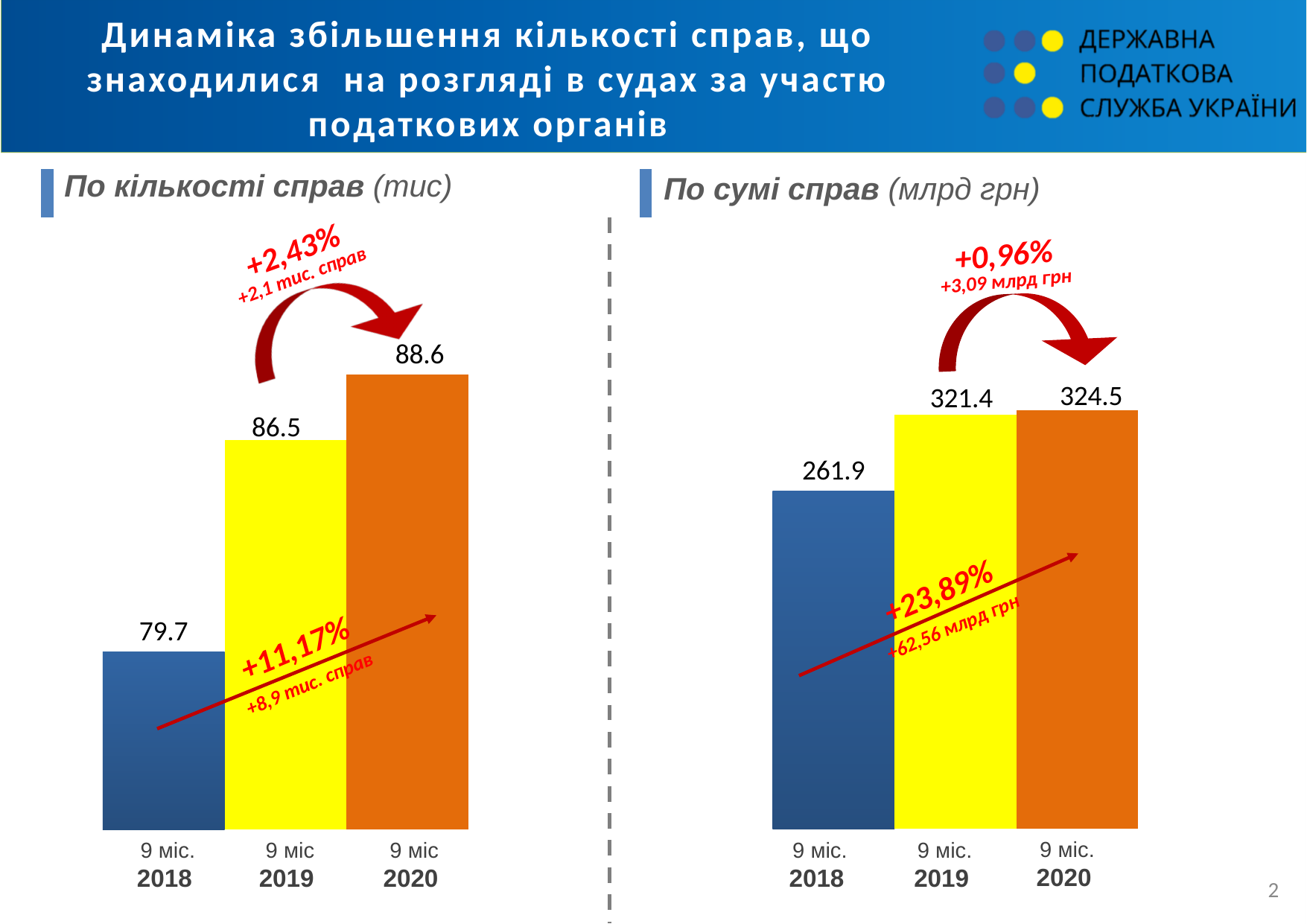
In the chart 'По сумі справ (млрд грн)', what is the value for 9 міс. 2018? 261.9 What kind of chart is the chart 'По сумі справ (млрд грн)'? Bar chart In the chart 'По кількості справ (тис)', what is the value for 9 міс. 2018? 79.7 In the chart 'По кількості справ (тис)', which period has the highest value? 9 міс. 2020 How many bars are shown in the chart 'По кількості справ (тис)'? 3 In the chart 'По кількості справ (тис)', do the values rise or fall from 2018 to 2020? Rise In the chart 'По сумі справ (млрд грн)', what is the value for 9 міс. 2019? 321.4 In the chart 'По кількості справ (тис)', what is the difference between the values for 9 міс. 2019 and 9 міс. 2018? 6.8 In the chart 'По сумі справ (млрд грн)', what is the difference between the values for 9 міс. 2020 and 9 міс. 2018? 62.6 In the chart 'По сумі справ (млрд грн)', which is larger: the value for 9 міс. 2019 or 9 міс. 2018? 9 міс. 2019 In the chart 'По сумі справ (млрд грн)', which period has the lowest value? 9 міс. 2018 In the chart 'По кількості справ (тис)', what is the value for 9 міс. 2020? 88.6